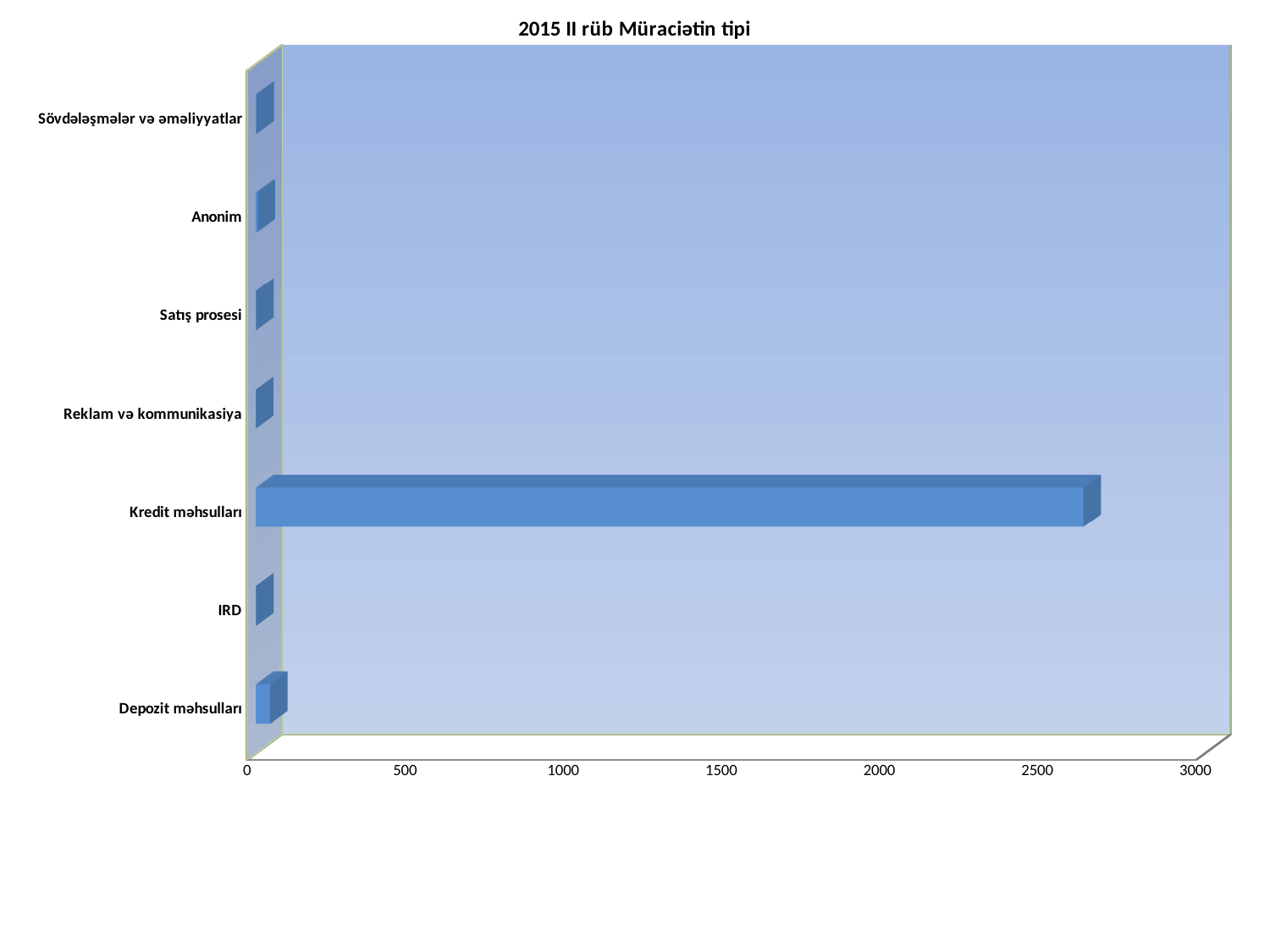
Which is larger, the value for Satış prosesi or the value for Kredit məhsulları? Kredit məhsulları What is the title of the chart? 2015 II rüb Müraciətin tipi Which is larger, the value for Kredit məhsulları or the value for IRD? Kredit məhsulları Which category has the highest value? Kredit məhsulları What is the maximum value shown on the horizontal axis? 3000 Is the value for Anonim greater or less than 500? less What type of chart is shown on the slide? bar chart Is the value for Kredit məhsulları greater or less than 2500? greater Is the value for Kredit məhsulları greater or less than 3000? less How many categories are shown on the chart? 7